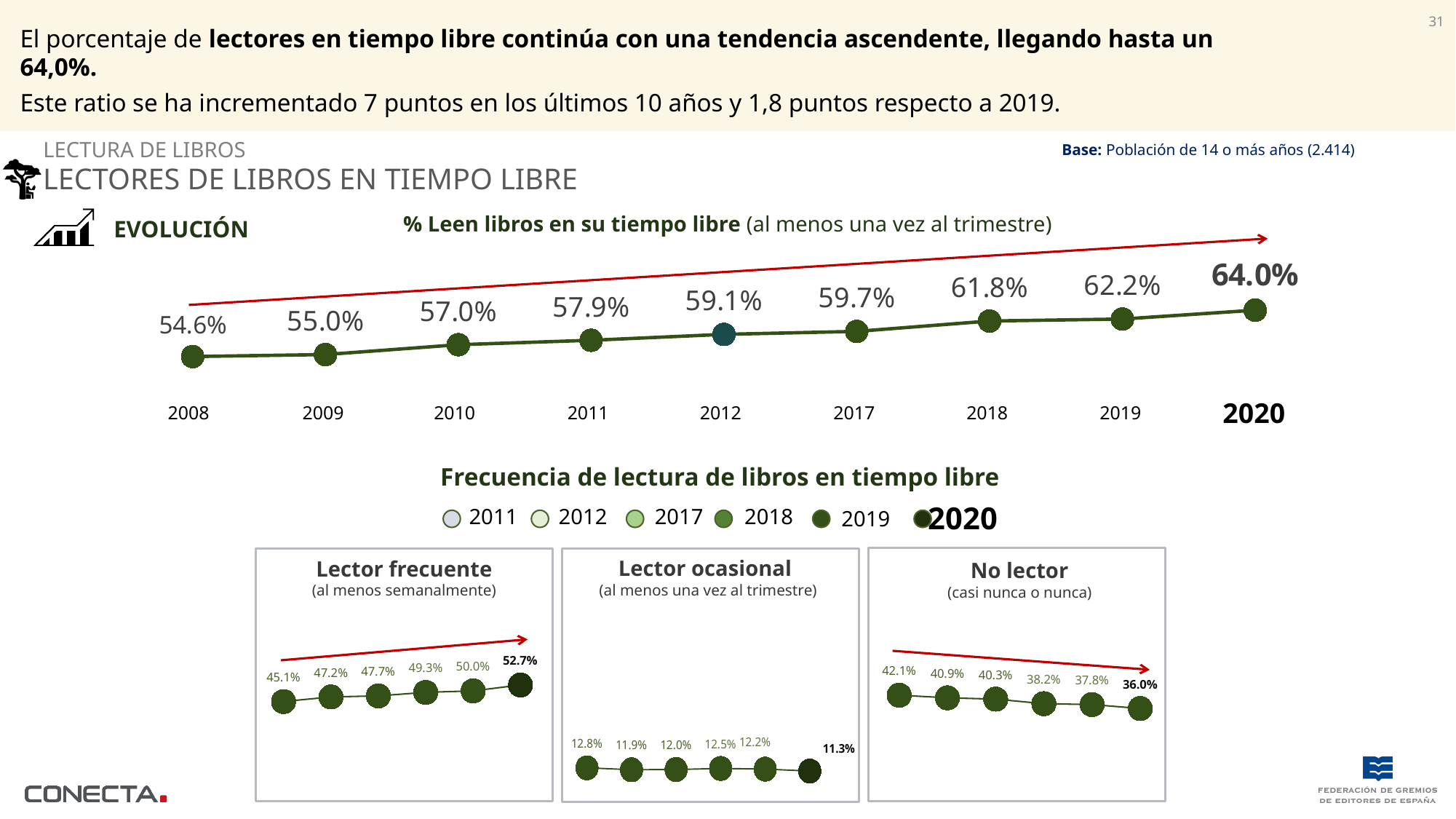
In the '% Leen libros en su tiempo libre' chart, what is the value for 2008? 54.6% In the 'Lector ocasional' chart, which year has the highest value? 2011 In the '% Leen libros en su tiempo libre' chart, do the values rise or fall from 2008 to 2020? rise In the '% Leen libros en su tiempo libre' chart, which year has the lowest value? 2008 In the '% Leen libros en su tiempo libre' chart, what is the difference between the 2020 and 2019 values? 1.8 percentage points In the '% Leen libros en su tiempo libre' chart, what is the value for 2020? 64.0% What kind of chart is the '% Leen libros en su tiempo libre' chart? line chart In the 'No lector' chart, what is the value for 2011? 42.1% In the 'Lector frecuente' chart, what is the value for 2020? 52.7% In the '% Leen libros en su tiempo libre' chart, how many years are plotted? 9 In the '% Leen libros en su tiempo libre' chart, what is the value for 2012? 59.1% How many years does the legend of the 'Frecuencia de lectura de libros en tiempo libre' charts list? 6